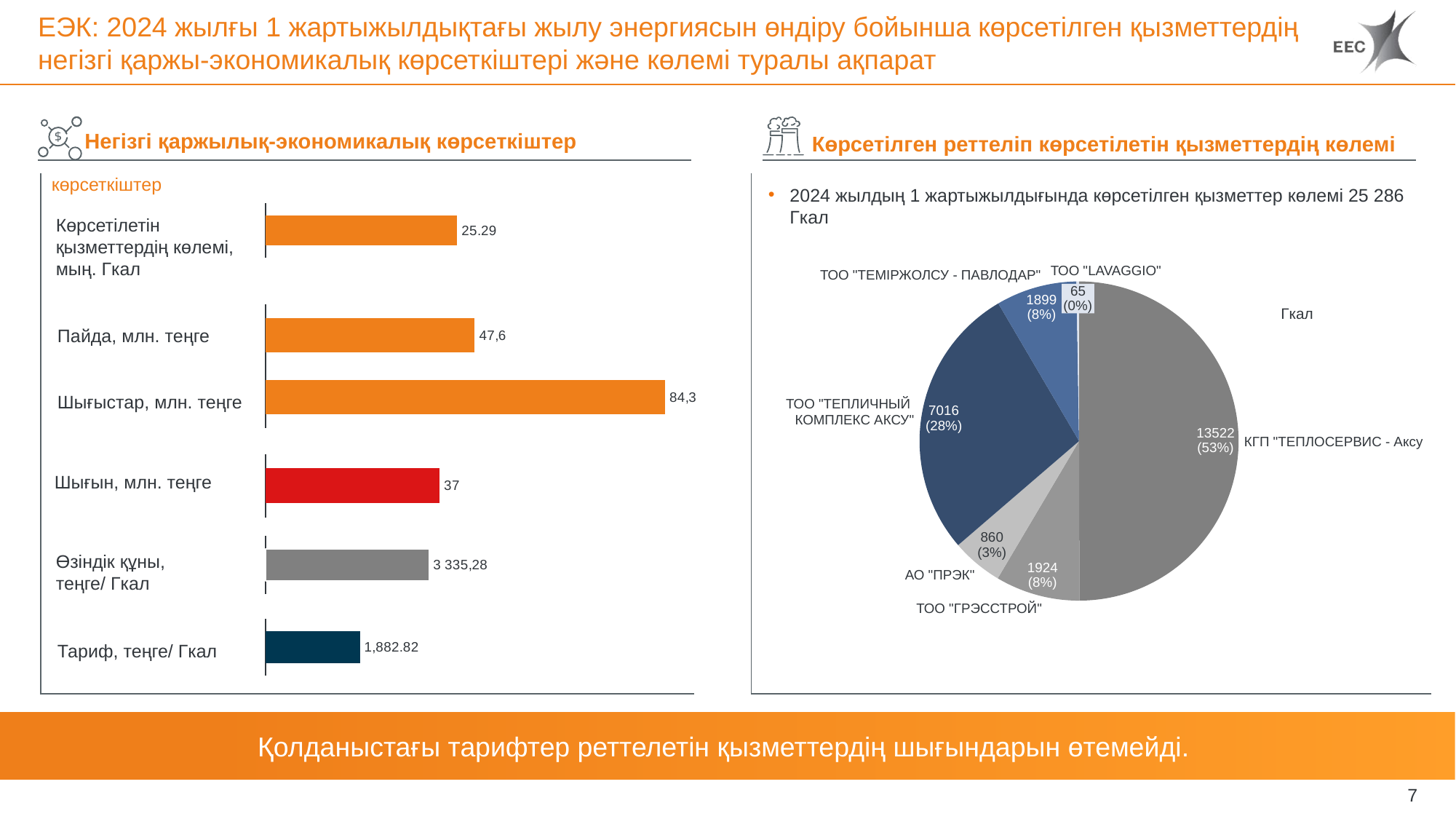
In the right pie chart, what is the value for КГП "ТЕПЛОСЕРВИС - Аксу"? 13522 In the right pie chart, which slice is the largest? КГП "ТЕПЛОСЕРВИС - Аксу" In the left bar chart, how many categories are shown? 6 In the left bar chart, what is the value for "Шығыстар, млн. теңге"? 84,3 What kind of chart is the left chart titled "Негізгі қаржылық-экономикалық көрсеткіштер"? bar chart In the right pie chart, what share does ТОО "ТЕПЛИЧНЫЙ КОМПЛЕКС АКСУ" have? 28% In the left bar chart, what is the value for "Пайда, млн. теңге"? 47,6 What kind of chart is the right chart titled "Көрсетілген реттеліп көрсетілетін қызметтердің көлемі"? pie chart In the right pie chart, which slice is the smallest? ТОО "LAVAGGIO" In the left bar chart, which is larger: "Шығыстар, млн. теңге" or "Шығын, млн. теңге"? Шығыстар, млн. теңге In the left bar chart, what is the value for "Өзіндік құны, теңге/ Гкал"? 3 335,28 In the left bar chart, what is the value for "Тариф, теңге/ Гкал"? 1,882.82